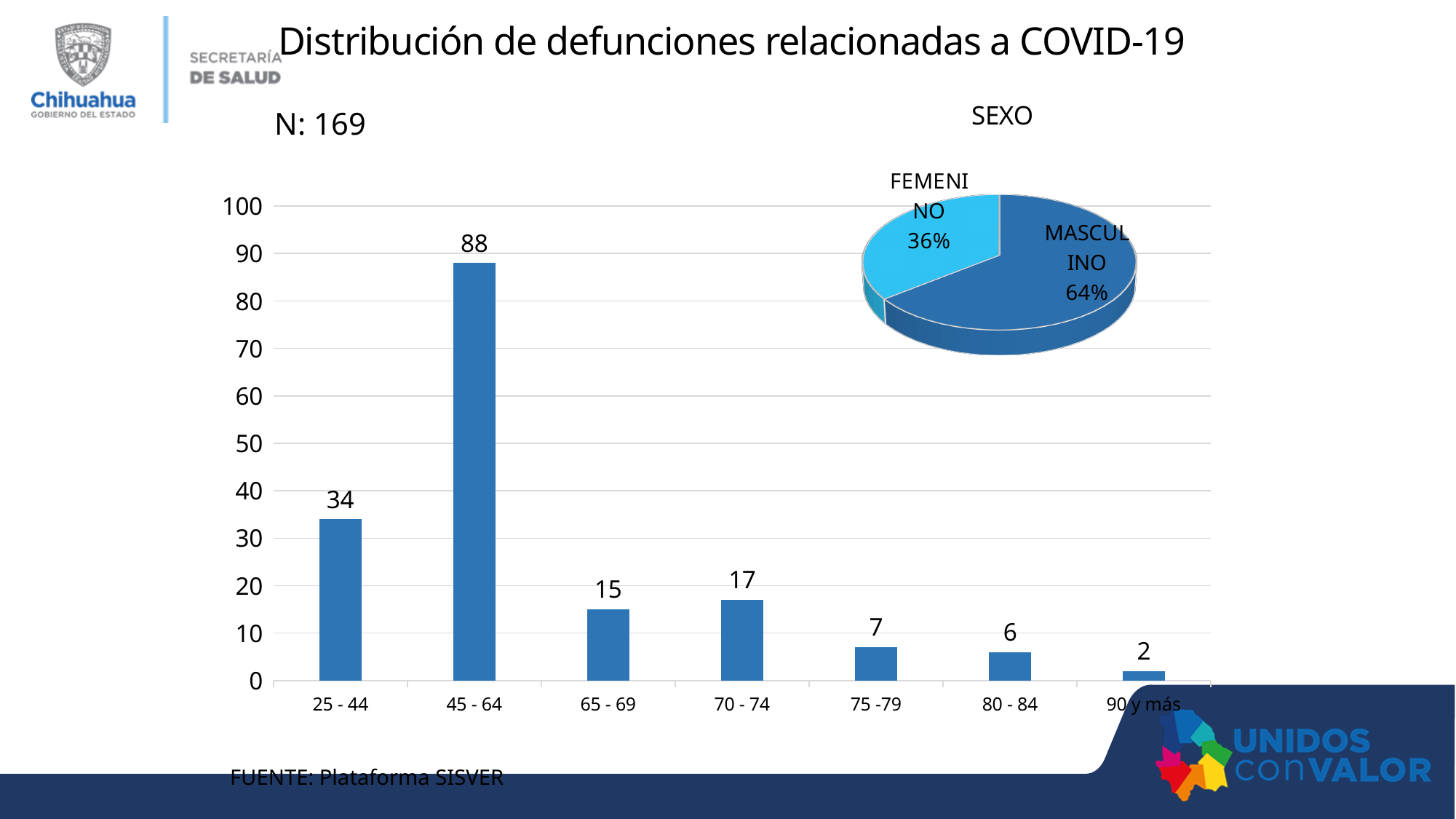
In the bar chart of deaths by age group, do the values rise or fall from 70 - 74 to 90 y más? fall In the bar chart of deaths by age group, how many age groups are shown on the x axis? 7 In the bar chart of deaths by age group, what is the difference between the values for 45 - 64 and 25 - 44? 54 In the SEXO pie chart, what share is MASCULINO? 64% In the bar chart of deaths by age group, which is larger, the value for 65 - 69 or the value for 70 - 74? 70 - 74 In the SEXO pie chart, what share is FEMENINO? 36% In the bar chart of deaths by age group, what is the value for the 45 - 64 age group? 88 In the bar chart of deaths by age group, which age group has the lowest value? 90 y más What kind of chart is the SEXO chart? pie chart What kind of chart is the chart on the left showing deaths by age group? bar chart In the bar chart of deaths by age group, what is the value for the 70 - 74 age group? 17 In the bar chart of deaths by age group, which age group has the highest value? 45 - 64